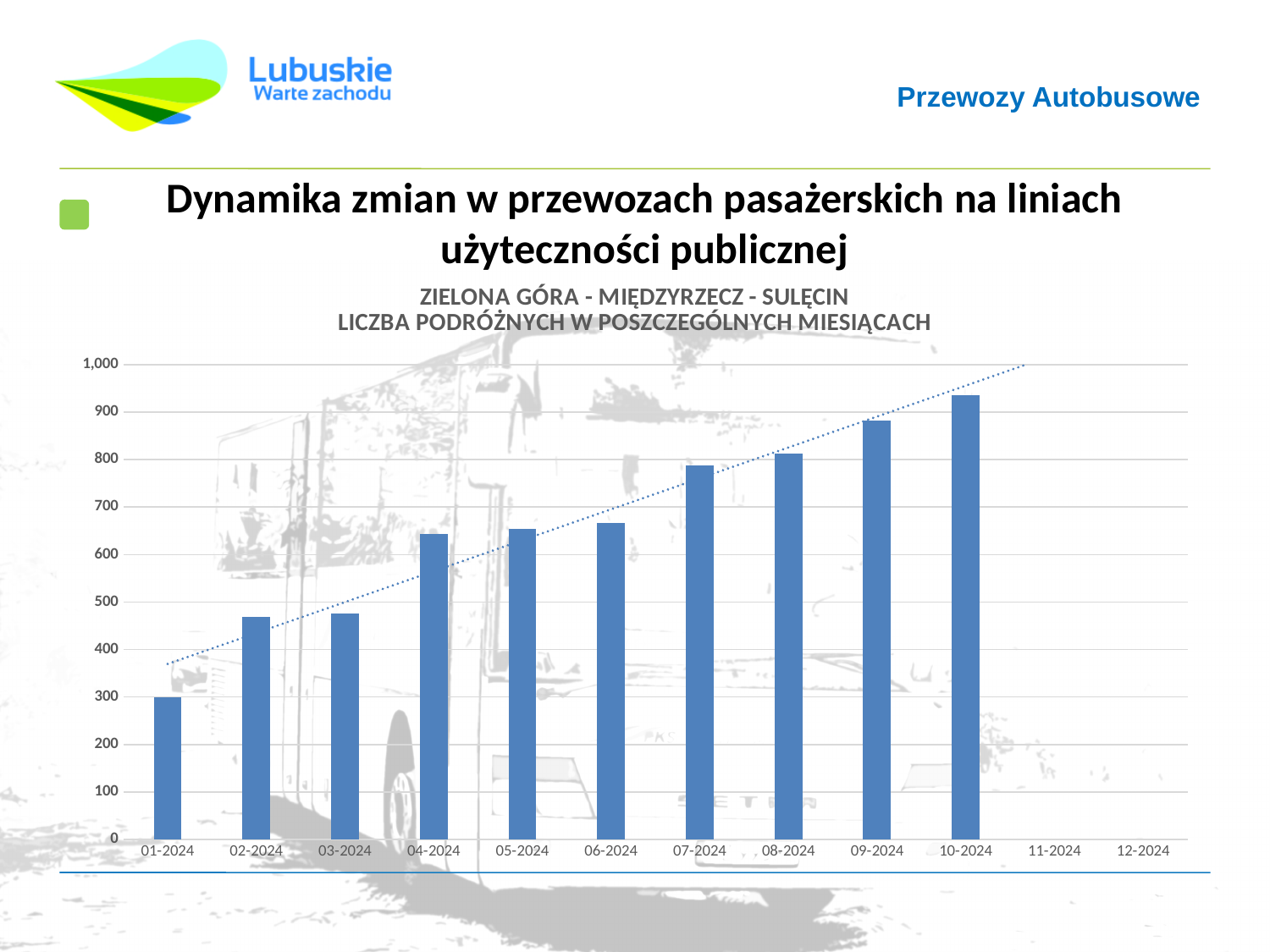
Is the value for 10-2024 greater or less than 900? greater Which month has the highest number of passengers? 10-2024 Which is larger, the value for 02-2024 or the value for 04-2024? 04-2024 What kind of chart is shown on the slide? bar chart Do the values generally rise or fall from 01-2024 to 10-2024? rise How many months have a bar plotted on the chart? 10 Is the value for 09-2024 greater or less than 800? greater Which month has the lowest number of passengers? 01-2024 Is the value for 04-2024 greater or less than 700? less Which route is named in the chart title? ZIELONA GÓRA - MIĘDZYRZECZ - SULĘCIN